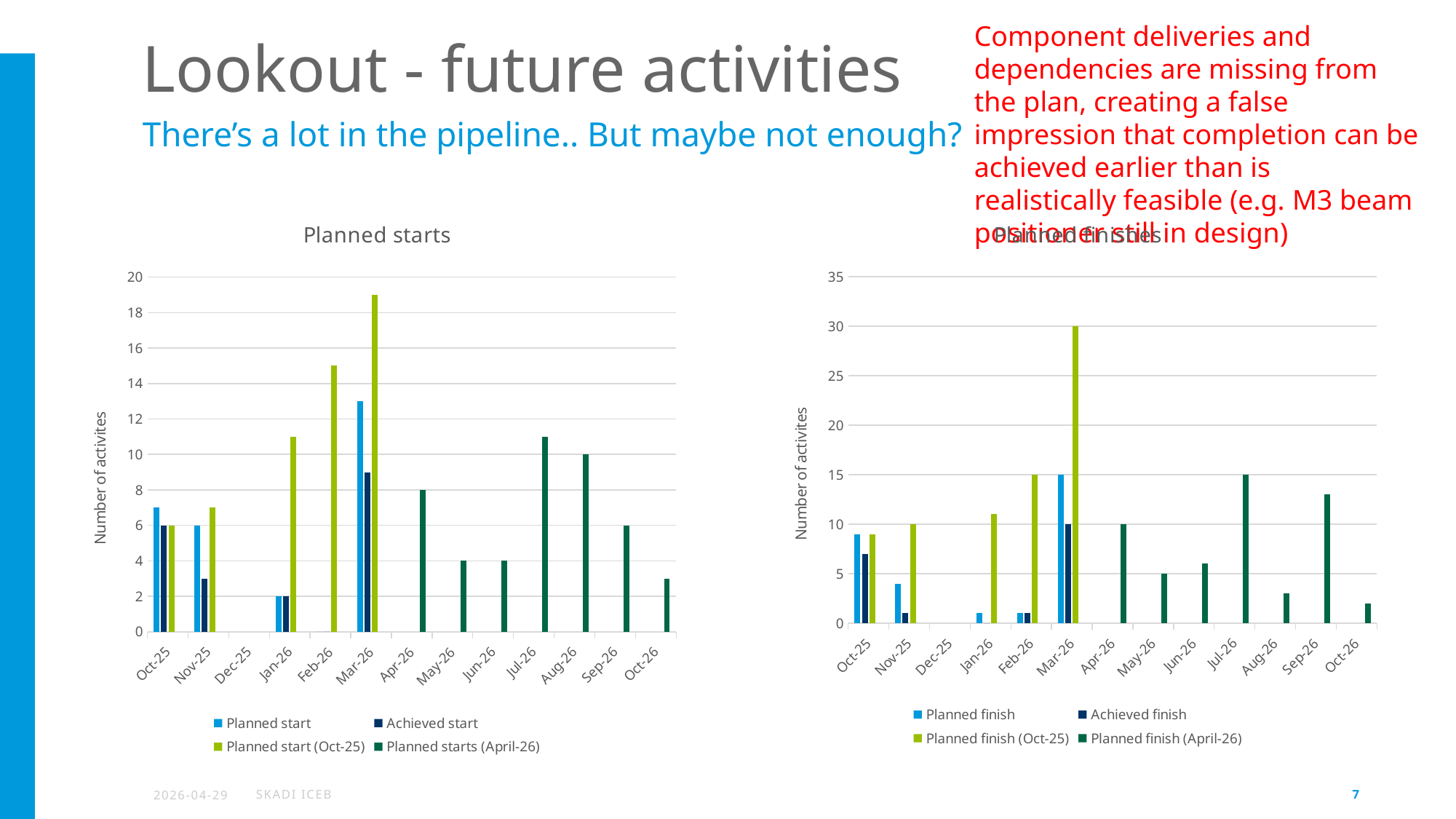
In the 'Planned starts' chart, which month has the larger 'Planned start' value, Oct-25 or Mar-26? Mar-26 In the 'Planned starts' chart, which month has the tallest bar overall? Mar-26 In the 'Planned finishes' chart on the right, how many series does the legend list? 4 What kind of chart is the 'Planned starts' chart on the left? bar chart In the 'Planned finishes' chart, is the 'Planned finish (Oct-25)' value for Mar-26 greater or less than 25? greater In the 'Planned finishes' chart, is the 'Planned finish (April-26)' value for Sep-26 greater or less than 10? greater In the 'Planned finishes' chart, which month has the tallest bar overall? Mar-26 In the 'Planned starts' chart, is the 'Planned starts (April-26)' value for Oct-26 greater or less than 4? less In the 'Planned finishes' chart, which month has the larger 'Planned finish (April-26)' value, Jul-26 or Aug-26? Jul-26 In the 'Planned starts' chart, how many series does the legend list? 4 In the 'Planned starts' chart, how many months are shown on the x axis? 13